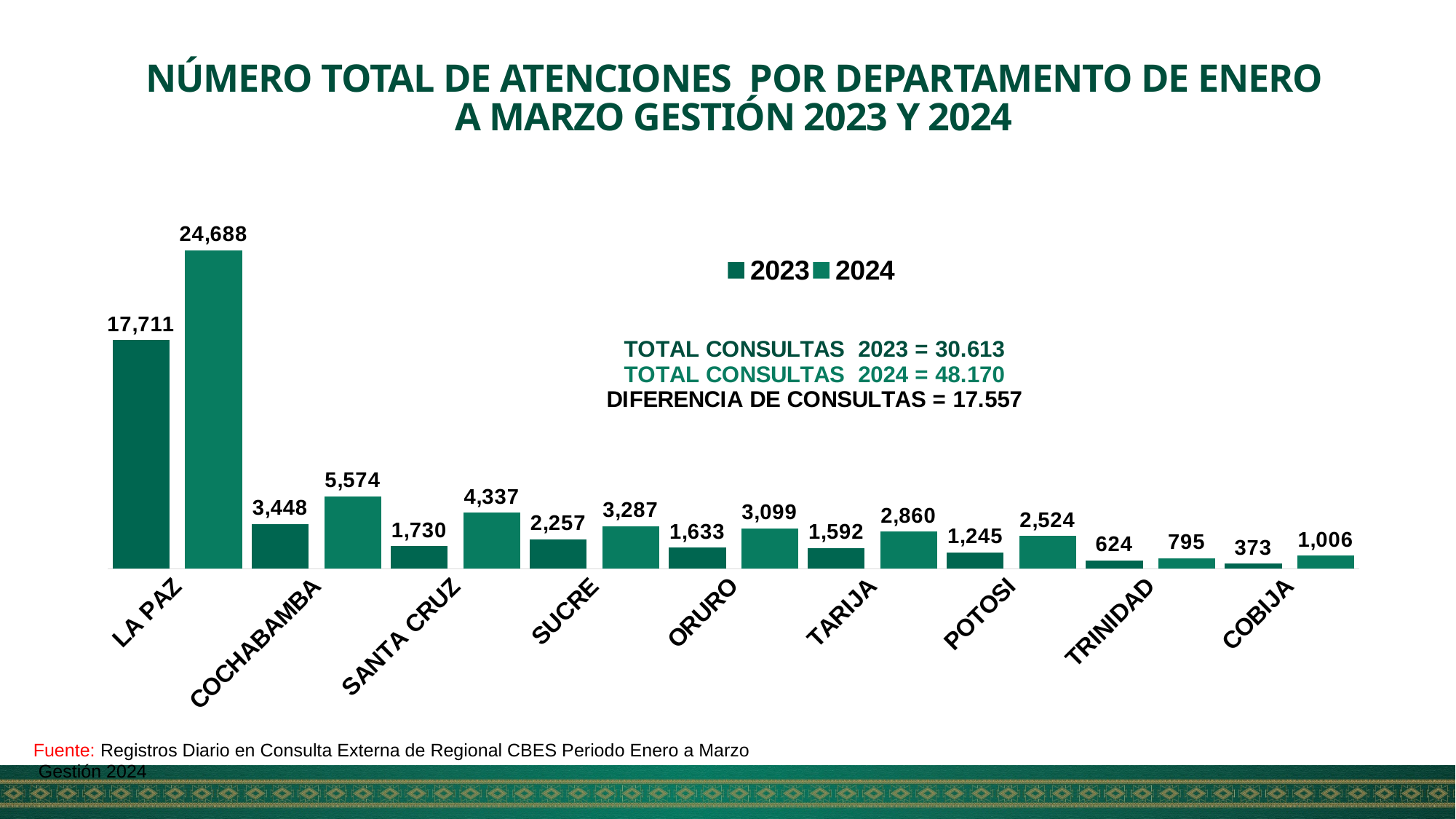
How many departments are shown on the x axis? 9 How many series does the legend list? 2 What is the difference between the 2024 and 2023 values for COBIJA? 633 Which is larger: the 2023 value for SUCRE or the 2023 value for TARIJA? SUCRE What kind of chart is shown on the slide? Bar chart What is the difference between the 2024 and 2023 values for COCHABAMBA? 2,126 What is the 2024 value for LA PAZ? 24,688 Which department has the lowest 2024 value? TRINIDAD What is the 2024 value for ORURO? 3,099 What is the 2023 value for SANTA CRUZ? 1,730 What are the two series listed in the legend? 2023 and 2024 Which department has the highest 2023 value? LA PAZ